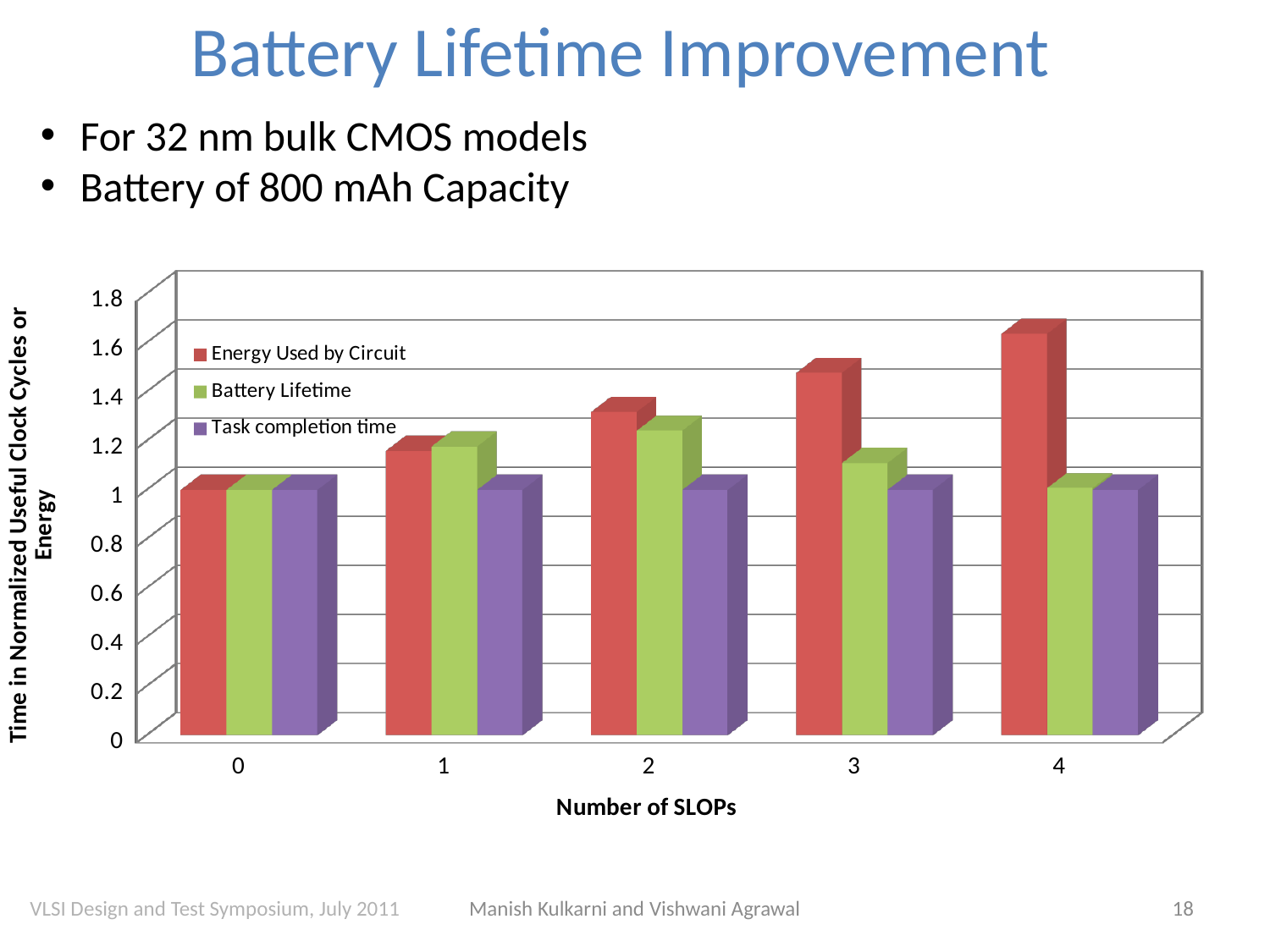
Does Energy Used by Circuit rise or fall as the number of SLOPs increases from 0 to 4? rise For which number of SLOPs is Energy Used by Circuit highest? 4 Is the value of Energy Used by Circuit at 4 SLOPs greater or less than 1.4? greater How many series does the legend list? 3 For which number of SLOPs is Energy Used by Circuit lowest? 0 How many categories are shown along the x axis (Number of SLOPs)? 5 What kind of chart is shown on the slide? bar chart Is the value of Battery Lifetime at 2 SLOPs greater or less than 1? greater Is the value of Task completion time at 4 SLOPs greater or less than 1.2? less What is the title of the x axis? Number of SLOPs At 4 SLOPs, which is larger: Energy Used by Circuit or Battery Lifetime? Energy Used by Circuit Which series is plotted in red? Energy Used by Circuit